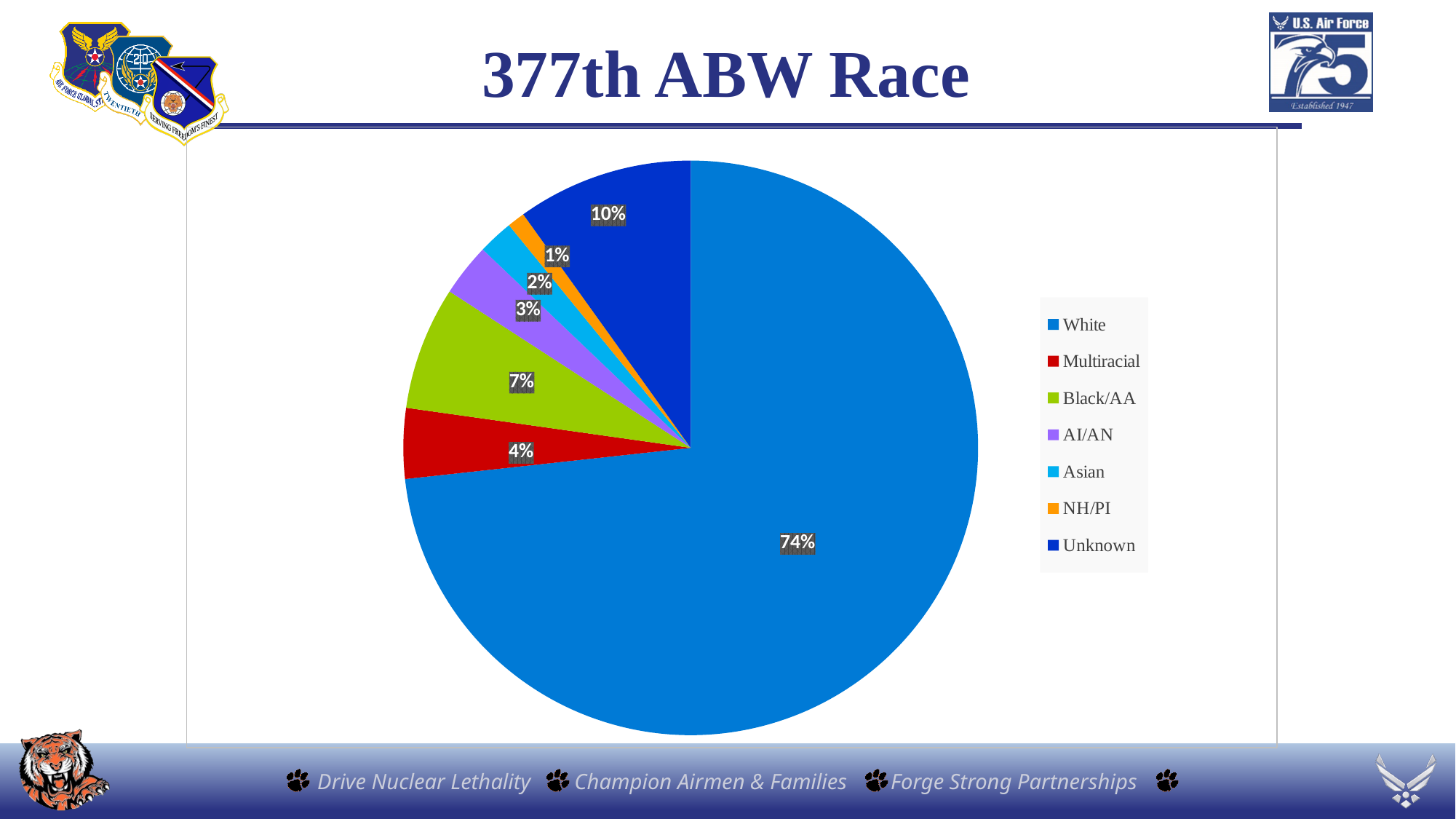
What is the difference in percentage points between White and Unknown? 64 Which category has the smallest slice of the pie? NH/PI What percentage is shown for Unknown? 10% What percentage is shown for Multiracial? 4% What is the title of the slide? 377th ABW Race What percentage is shown for Black/AA? 7% What share of the pie does White represent? 74% Which category has the largest slice of the pie? White Which is larger, the share for Black/AA or the share for AI/AN? Black/AA What kind of chart is shown on the slide? Pie chart How many categories does the legend list? 7 What percentage is shown for NH/PI? 1%